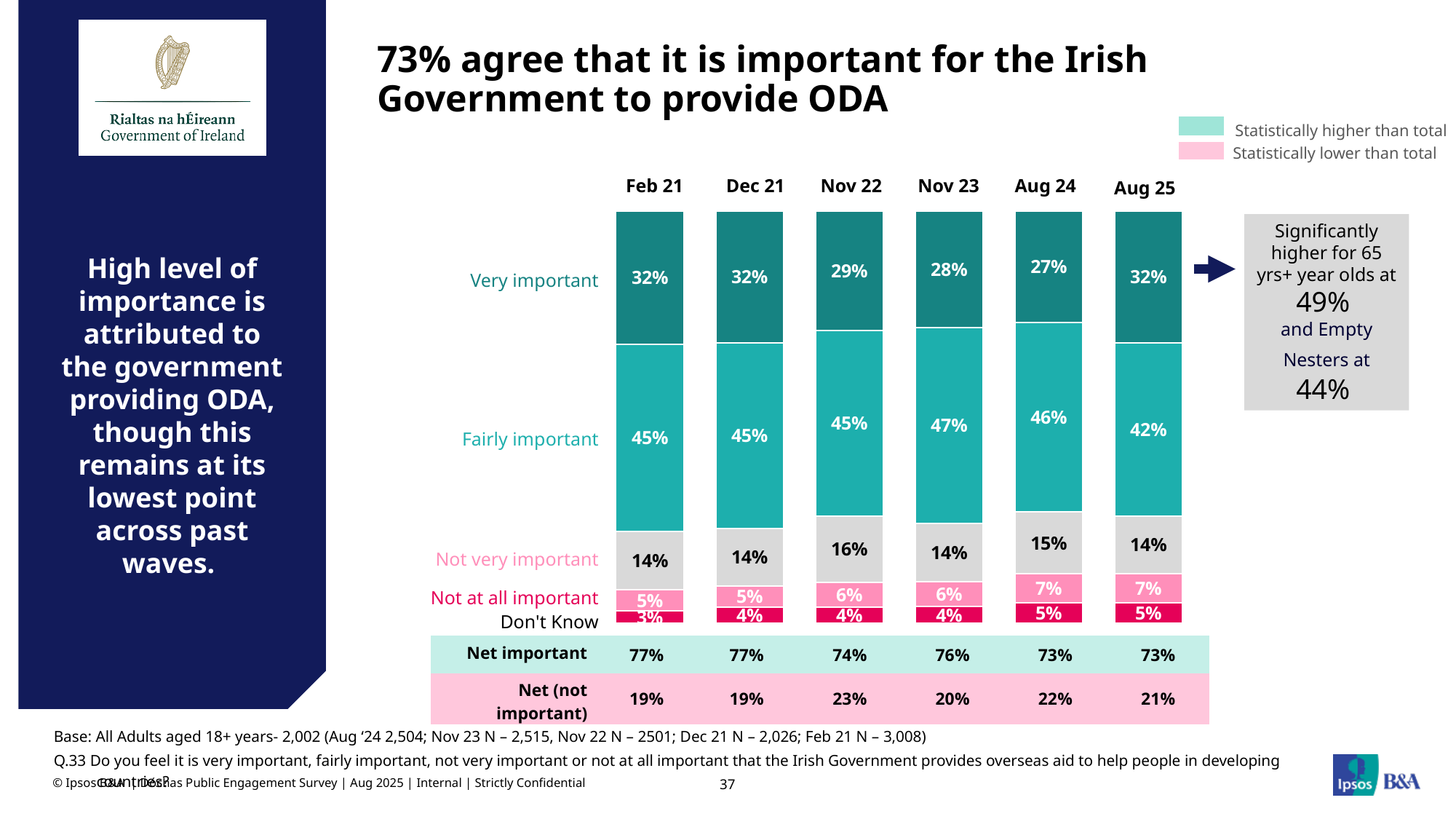
In which wave is the 'Fairly important' share highest? Nov 23 By how many percentage points did 'Fairly important' fall from Aug 24 to Aug 25? 4 percentage points What type of chart is used on this slide? Stacked bar chart Which wave has the larger 'Not at all important' share, Feb 21 or Aug 24? Aug 24 What is the 'Net important' figure for Aug 25? 73% Does the 'Don't Know' share rise or fall from Feb 21 to Aug 25? Rise What percentage said 'Very important' in Aug 25? 32% How many response categories are stacked in each bar? 5 What is the 'Not very important' value for Nov 22? 16% In which wave is the 'Very important' share lowest? Aug 24 What percentage said 'Fairly important' in Nov 23? 47% How many survey waves are shown in the chart? 6